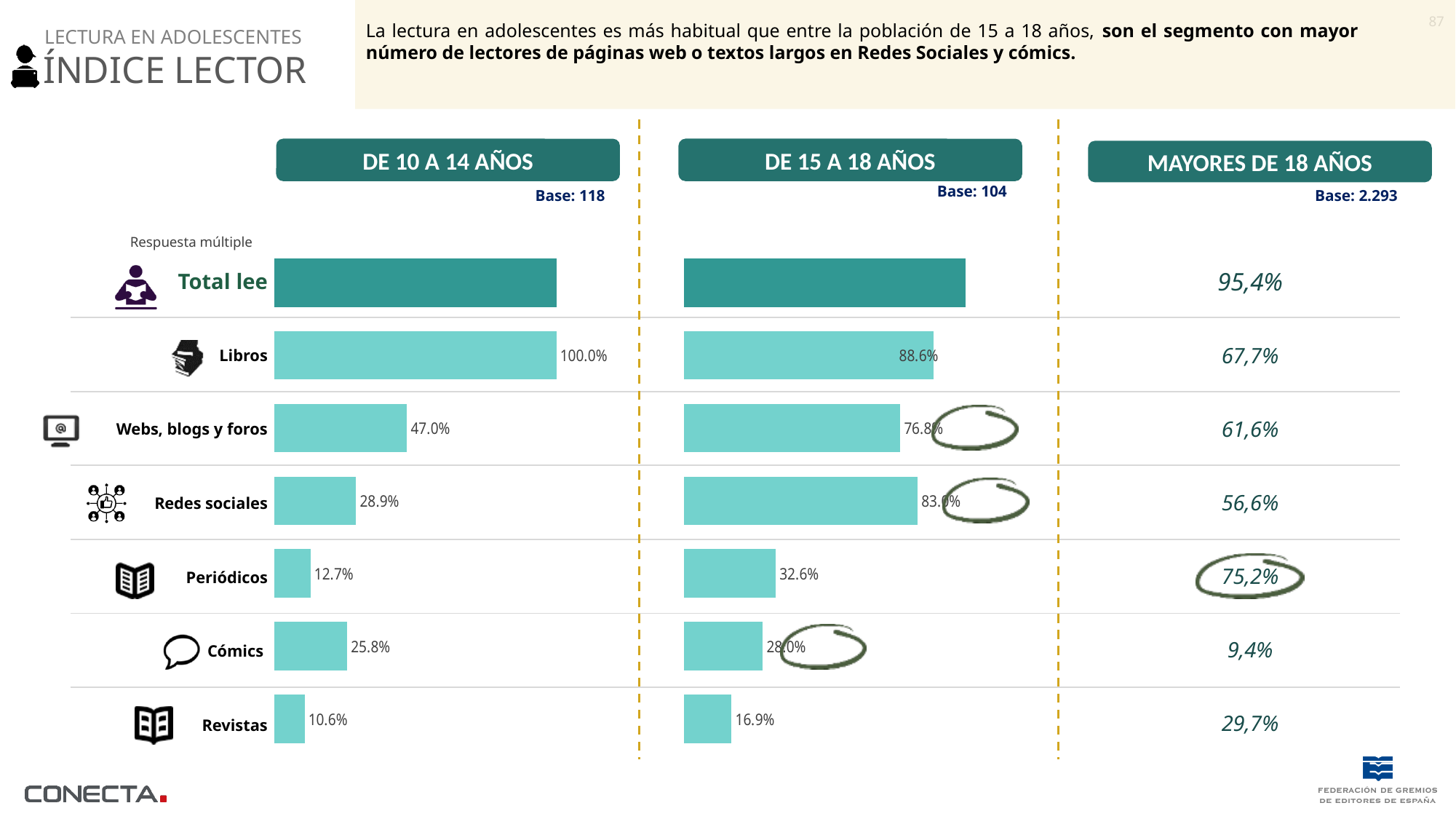
In the 'DE 10 A 14 AÑOS' chart, what is the difference between the values for Libros and Webs, blogs y foros? 53.0% What is the base (sample size) shown for the 'DE 15 A 18 AÑOS' chart? 104 Which is larger: the value for Cómics in the 'DE 10 A 14 AÑOS' chart or in the 'DE 15 A 18 AÑOS' chart? DE 15 A 18 AÑOS In the 'DE 15 A 18 AÑOS' chart, what is the difference between the values for Periódicos and Cómics? 4.6% In the 'DE 10 A 14 AÑOS' chart, which labelled category has the lowest value? Revistas In the 'DE 10 A 14 AÑOS' chart, what is the value for Webs, blogs y foros? 47.0% In the 'DE 10 A 14 AÑOS' chart, which is larger: Redes sociales or Cómics? Redes sociales In the 'DE 15 A 18 AÑOS' chart, what is the value for Periódicos? 32.6% In the 'DE 15 A 18 AÑOS' chart, what is the value for Revistas? 16.9% In the 'DE 10 A 14 AÑOS' chart, what is the value for Libros? 100.0% What kind of chart is used for the 'DE 10 A 14 AÑOS' data? Bar chart In the 'DE 15 A 18 AÑOS' chart, which labelled category has the highest value? Libros